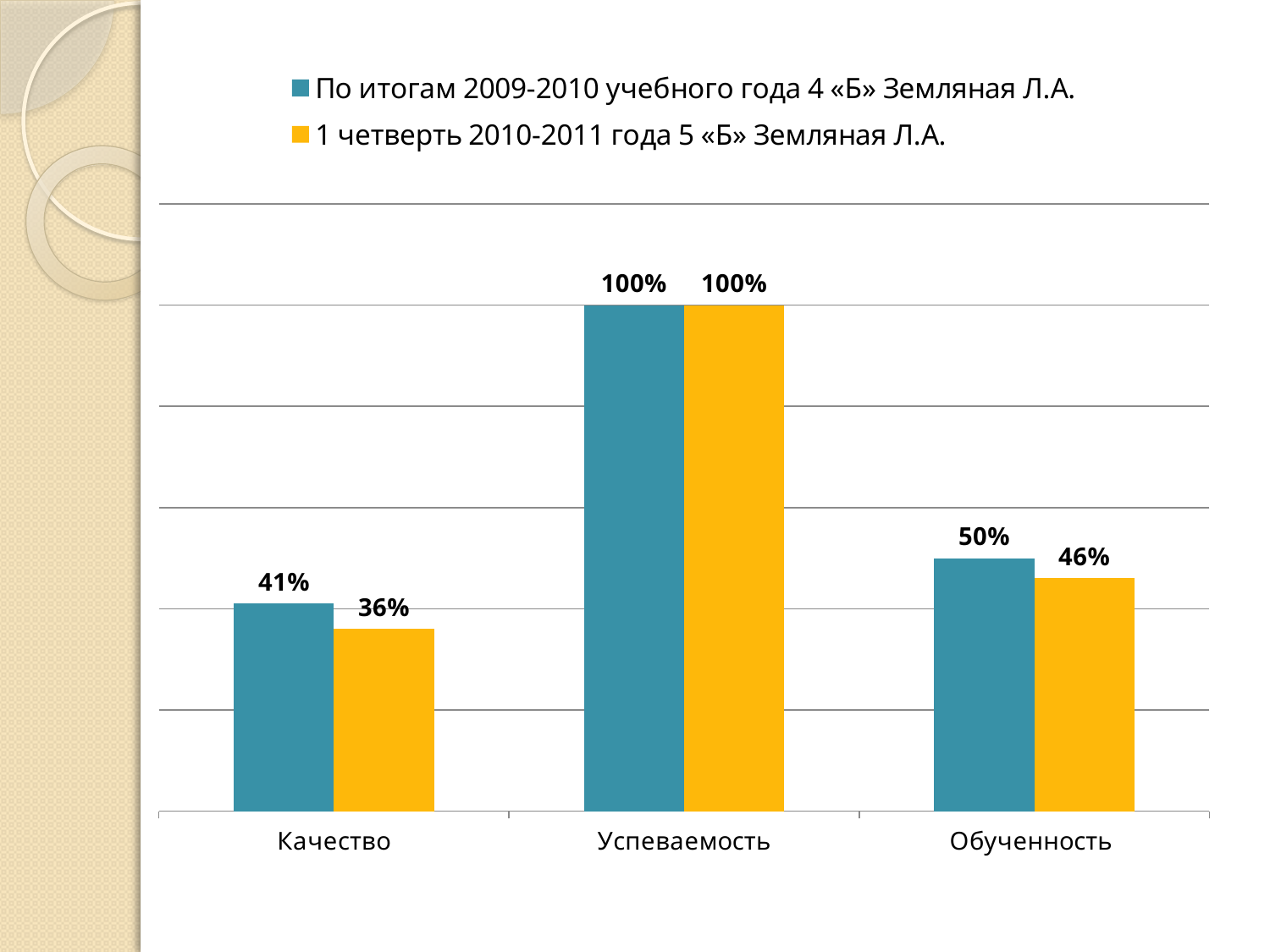
What is the difference between the two series' values for Качество? 5% For Качество, which series has the larger value? По итогам 2009-2010 учебного года 4 «Б» Земляная Л.А. How many series does the legend list? 2 Which category has the highest value in the series «1 четверть 2010-2011 года 5 «Б» Земляная Л.А.»? Успеваемость What is the value for Обученность in the series «1 четверть 2010-2011 года 5 «Б» Земляная Л.А.»? 46% What kind of chart is shown on the slide? Bar chart What is the value for Качество in the series «1 четверть 2010-2011 года 5 «Б» Земляная Л.А.»? 36% What is the value for Качество in the series «По итогам 2009-2010 учебного года 4 «Б» Земляная Л.А.»? 41% Which category has the lowest value in the series «По итогам 2009-2010 учебного года 4 «Б» Земляная Л.А.»? Качество How many categories are shown on the x axis? 3 What is the value for Успеваемость in the series «По итогам 2009-2010 учебного года 4 «Б» Земляная Л.А.»? 100% What is the difference between the two series' values for Обученность? 4%